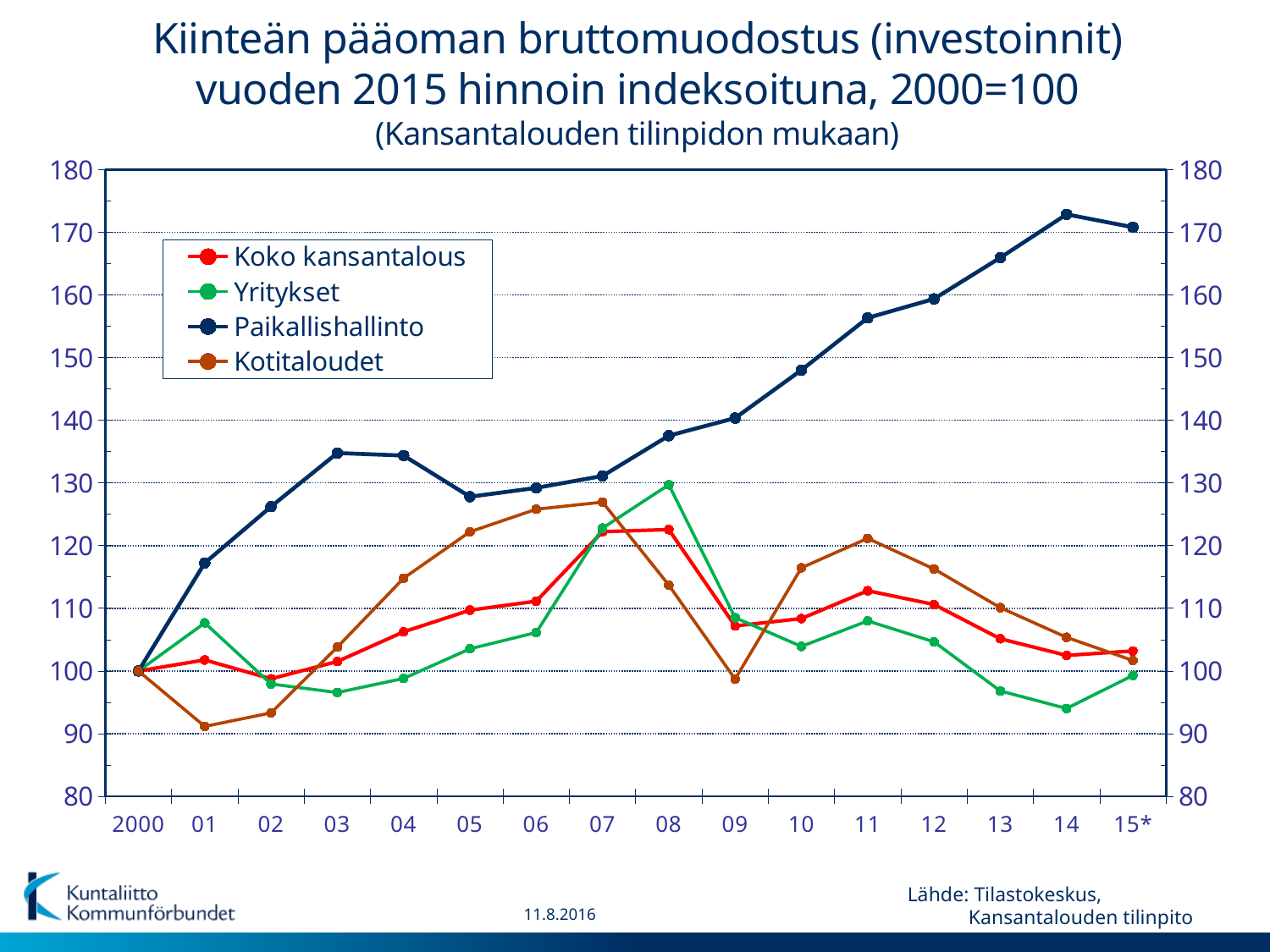
How many series does the legend list? 4 What is the value of Paikallishallinto in 2000? 100 Is the value for Kotitaloudet in 01 greater or less than 100? less Does the Paikallishallinto line generally rise or fall from 2000 to 15*? rise Is the value for Paikallishallinto in 10 greater or less than 150? less How many years are plotted along the x axis? 16 Is the value for Paikallishallinto in 14 greater or less than 170? greater In which year does Paikallishallinto reach its highest value? 14 In 10, which is larger: Kotitaloudet or Yritykset? Kotitaloudet What kind of chart is shown on the slide? line chart Which series has the highest value in 15*? Paikallishallinto